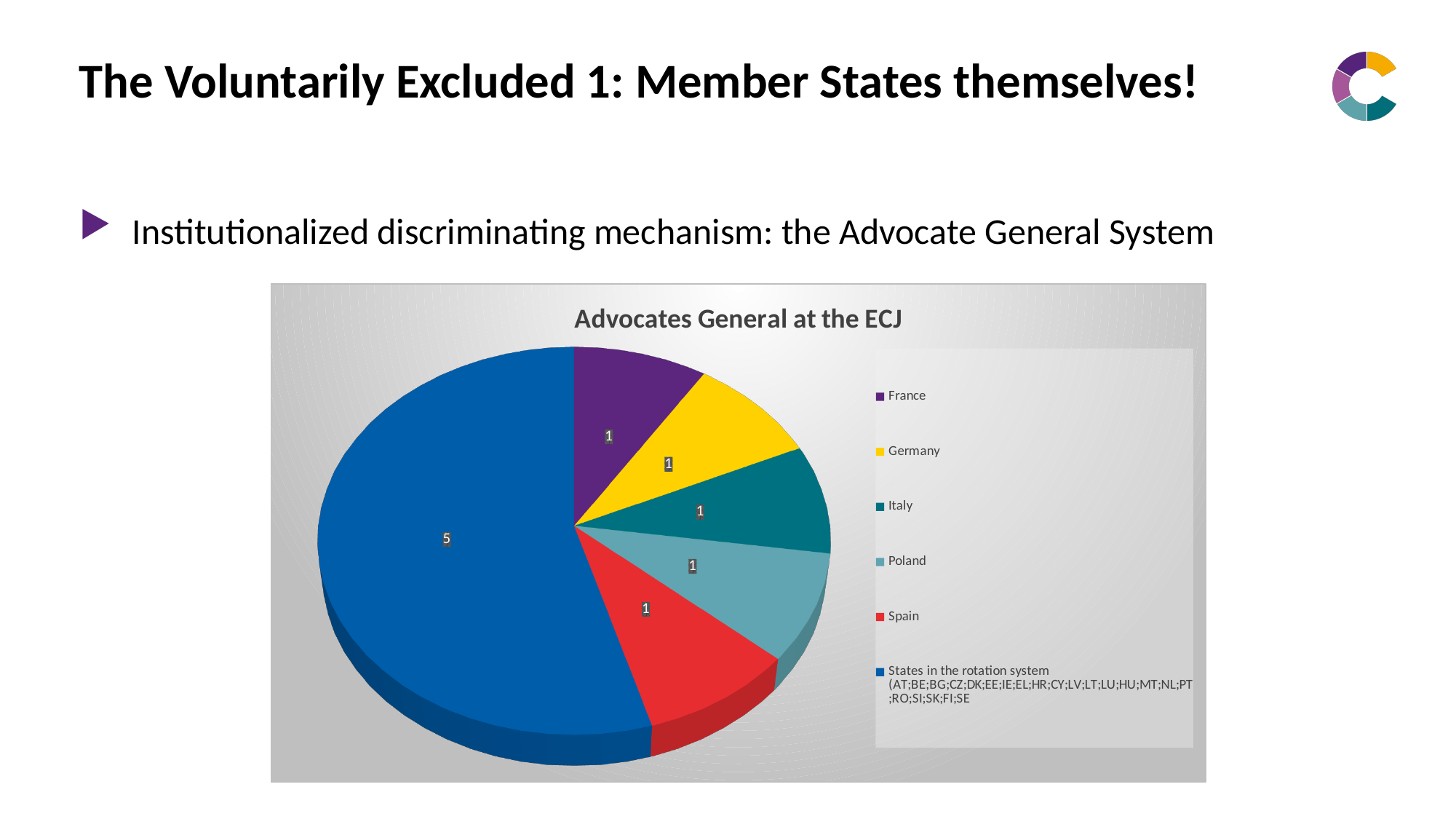
What is the difference between the value for States in the rotation system and the value for Germany? 4 What is the title of the chart? Advocates General at the ECJ What type of chart is shown on the slide? pie chart How many categories does the pie chart show? 6 Which category has the largest slice in the pie chart? States in the rotation system What is the value for France in the pie chart? 1 What is the value for States in the rotation system in the pie chart? 5 What is the total of all values in the pie chart? 10 What is the value for Spain in the pie chart? 1 Which is larger, the value for States in the rotation system or the value for Italy? States in the rotation system